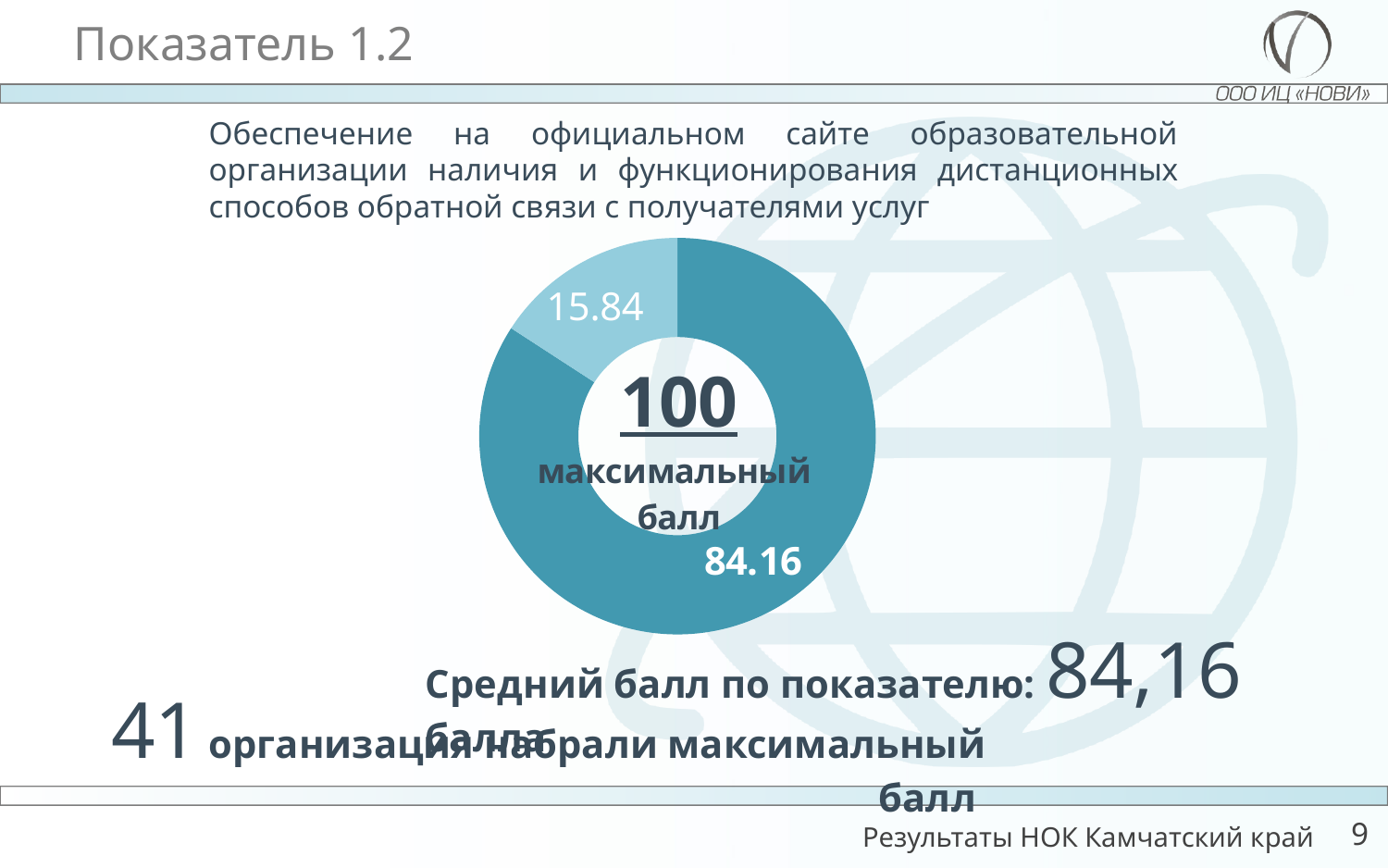
What is the smallest value shown on the chart? 15.84 Which slice is larger, the dark teal one or the light teal one? the dark teal one What value is printed on the larger, dark teal slice of the chart? 84.16 What is the difference between the two slice values, 84.16 and 15.84? 68.32 What share of the whole does the slice labelled 84.16 represent? 84.16% What number is printed in the centre of the doughnut chart? 100 What is the total of the two slice values on the chart? 100 What kind of chart is shown on the slide? doughnut (pie) chart What is the largest value shown on the chart? 84.16 What value is printed on the smaller, light teal slice of the chart? 15.84 How many slices does the doughnut chart have? 2 What text appears below the number in the centre of the doughnut chart? максимальный балл